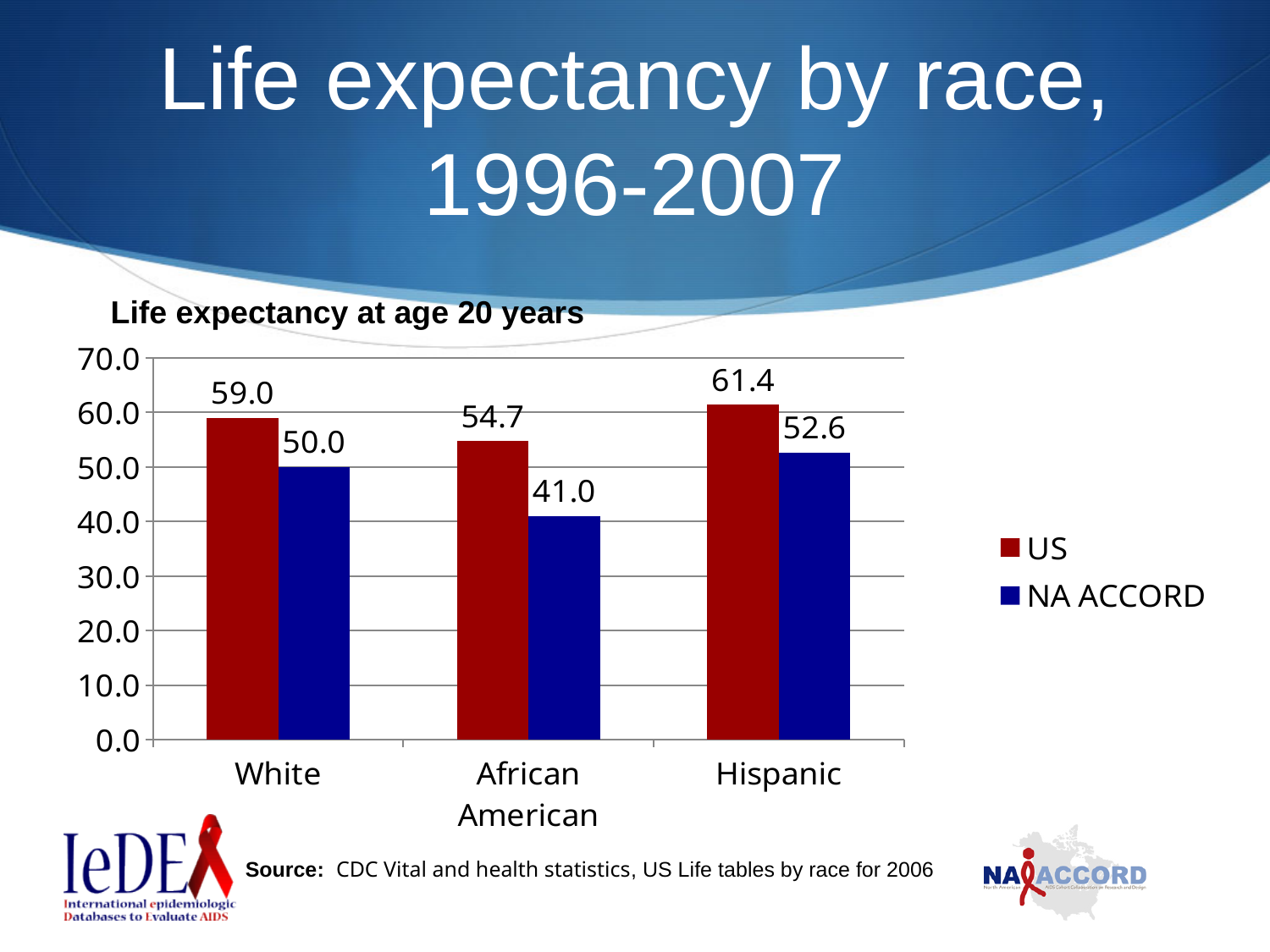
Which race has the highest US life expectancy at age 20? Hispanic Which is larger, the NA ACCORD value for White or for Hispanic? Hispanic What is the US life expectancy at age 20 for White? 59.0 How many race categories are shown on the x axis? 3 How many series does the legend list? 2 Which race has the lowest NA ACCORD value? African American What kind of chart is shown? Bar chart What is the difference between the US and NA ACCORD values for African American? 13.7 What is the difference between the US values for Hispanic and White? 2.4 What is the NA ACCORD value for Hispanic? 52.6 Which colour represents the NA ACCORD series? Blue What is the NA ACCORD value for African American? 41.0